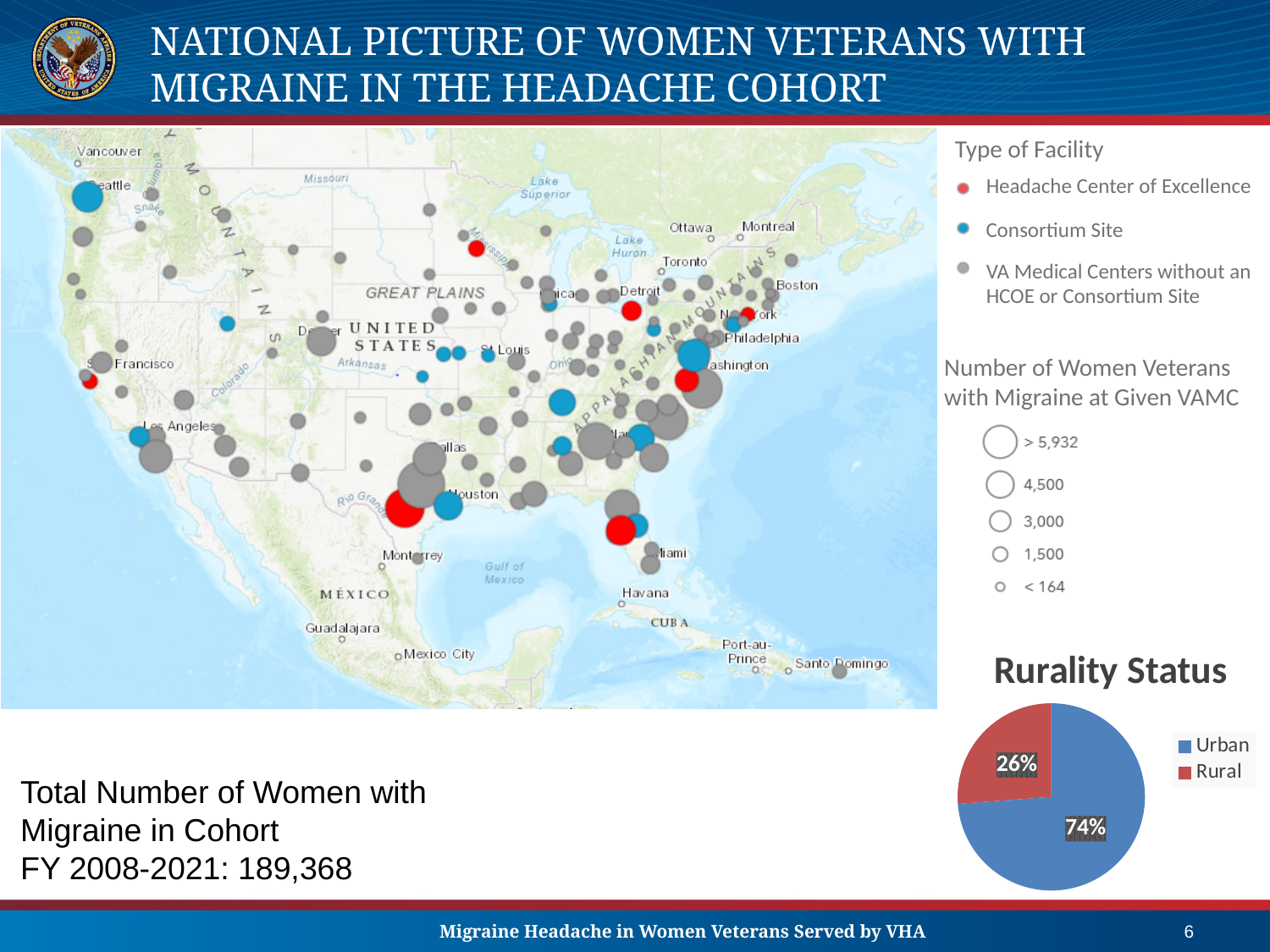
In the Rurality Status pie chart, which category has the largest share? Urban In the Rurality Status pie chart, what percentage is Urban? 74% In the Rurality Status pie chart, what is the difference in percentage points between Urban and Rural? 48 percentage points In the Rurality Status pie chart, which is larger, Urban or Rural? Urban How many categories does the Rurality Status pie chart show? 2 In the Rurality Status pie chart, which category has the smallest share? Rural On the map, how many types of facility does the 'Type of Facility' legend list? 3 In the Rurality Status pie chart, what percentage is Rural? 26% What share of the Rurality Status pie does the Rural slice represent? 26% How many entries does the legend of the Rurality Status chart list? 2 In the Rurality Status pie chart, what colour is the Urban slice? Blue What kind of chart is the Rurality Status chart? Pie chart